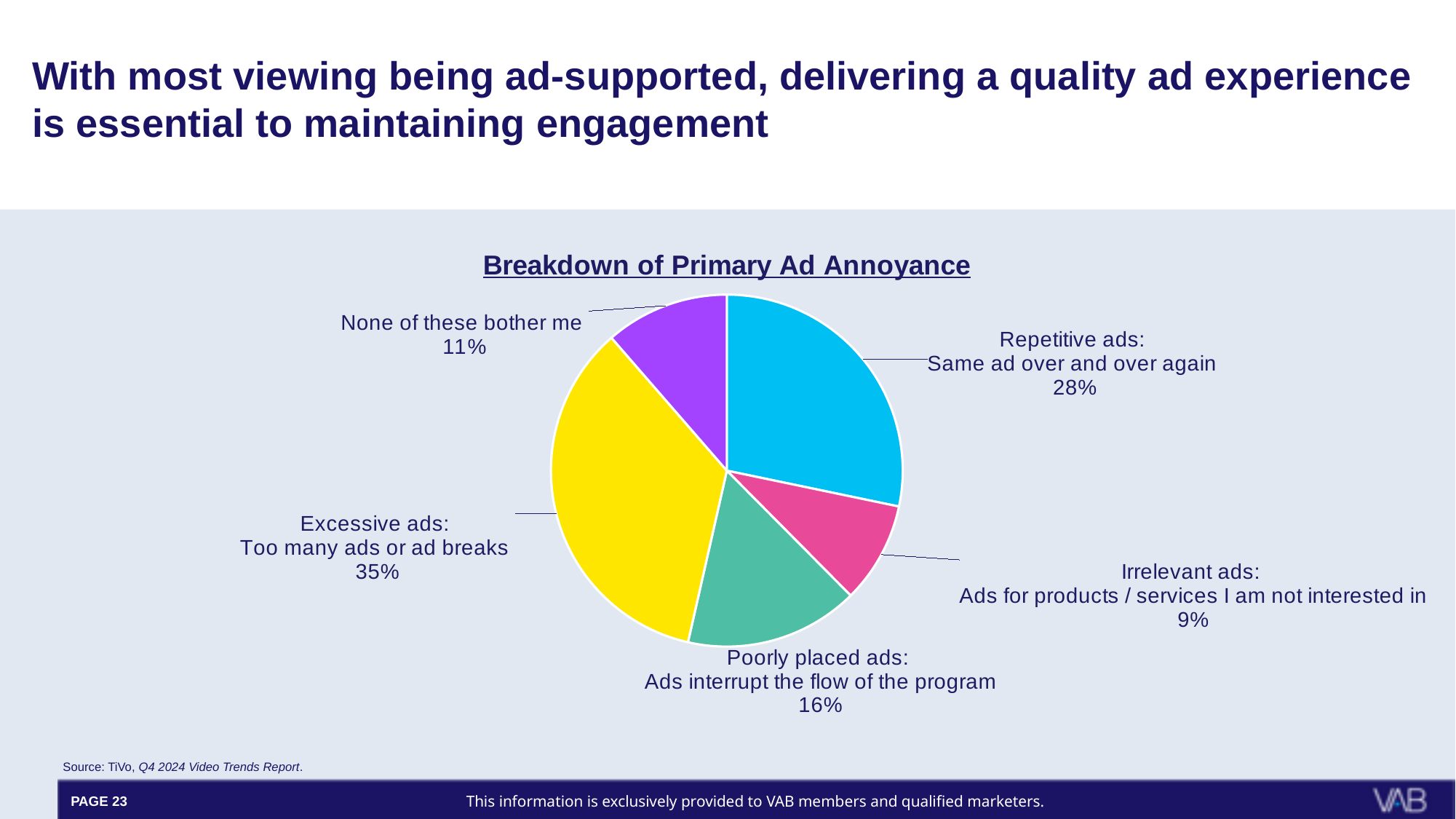
What is the difference in percentage points between Excessive ads and Repetitive ads? 7 What kind of chart is shown on the slide? Pie chart What share of the pie is Repetitive ads: Same ad over and over again? 28% What percentage is shown for None of these bother me? 11% What percentage is shown for Irrelevant ads: Ads for products / services I am not interested in? 9% What percentage is shown for Poorly placed ads: Ads interrupt the flow of the program? 16% How many slices does the pie chart have? 5 Which category has the largest slice of the pie? Excessive ads: Too many ads or ad breaks Which is larger, the share for Poorly placed ads or the share for None of these bother me? Poorly placed ads What is the title of the chart? Breakdown of Primary Ad Annoyance What share of the pie is Excessive ads: Too many ads or ad breaks? 35% Which category has the smallest slice of the pie? Irrelevant ads: Ads for products / services I am not interested in